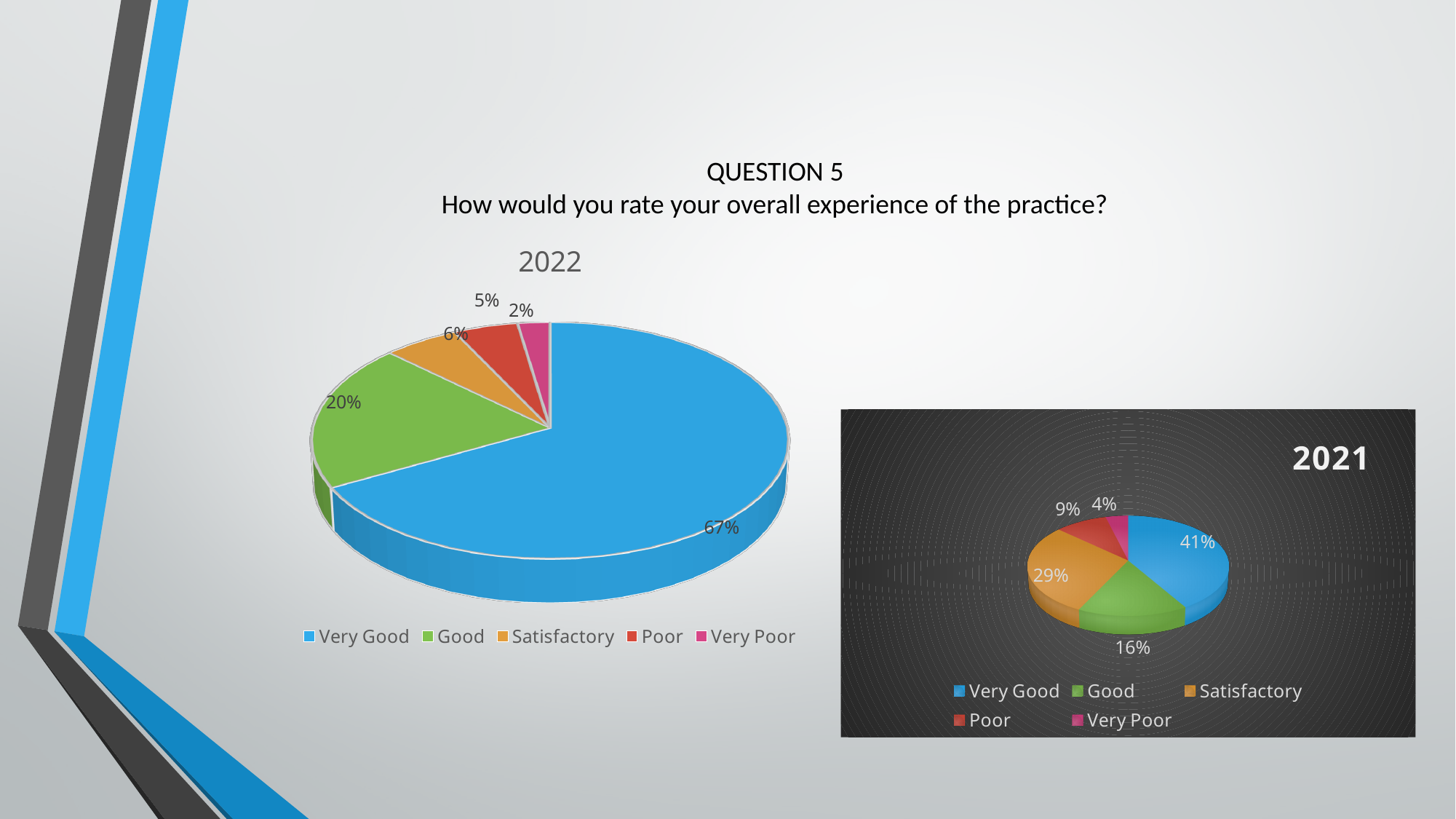
What type of chart is the 2021 chart? Pie chart In the 2022 chart, what percentage of respondents rated their experience as Very Good? 67% In the 2021 chart, which category has the smallest slice? Very Poor In the 2021 chart, what percentage is shown for Satisfactory? 29% How many categories does the legend of the 2022 chart list? 5 In the 2021 chart, which is larger: Satisfactory or Good? Satisfactory What is the difference between the Very Good share in 2022 and the Very Good share in 2021? 26 percentage points In the 2022 chart, what is the combined share of Poor and Very Poor? 7% In the 2021 chart, what percentage is shown for Very Poor? 4% In the 2022 chart, which category has the largest slice? Very Good In the 2022 chart, what share is shown for Good? 20% In the 2022 chart, which category has the smallest slice? Very Poor